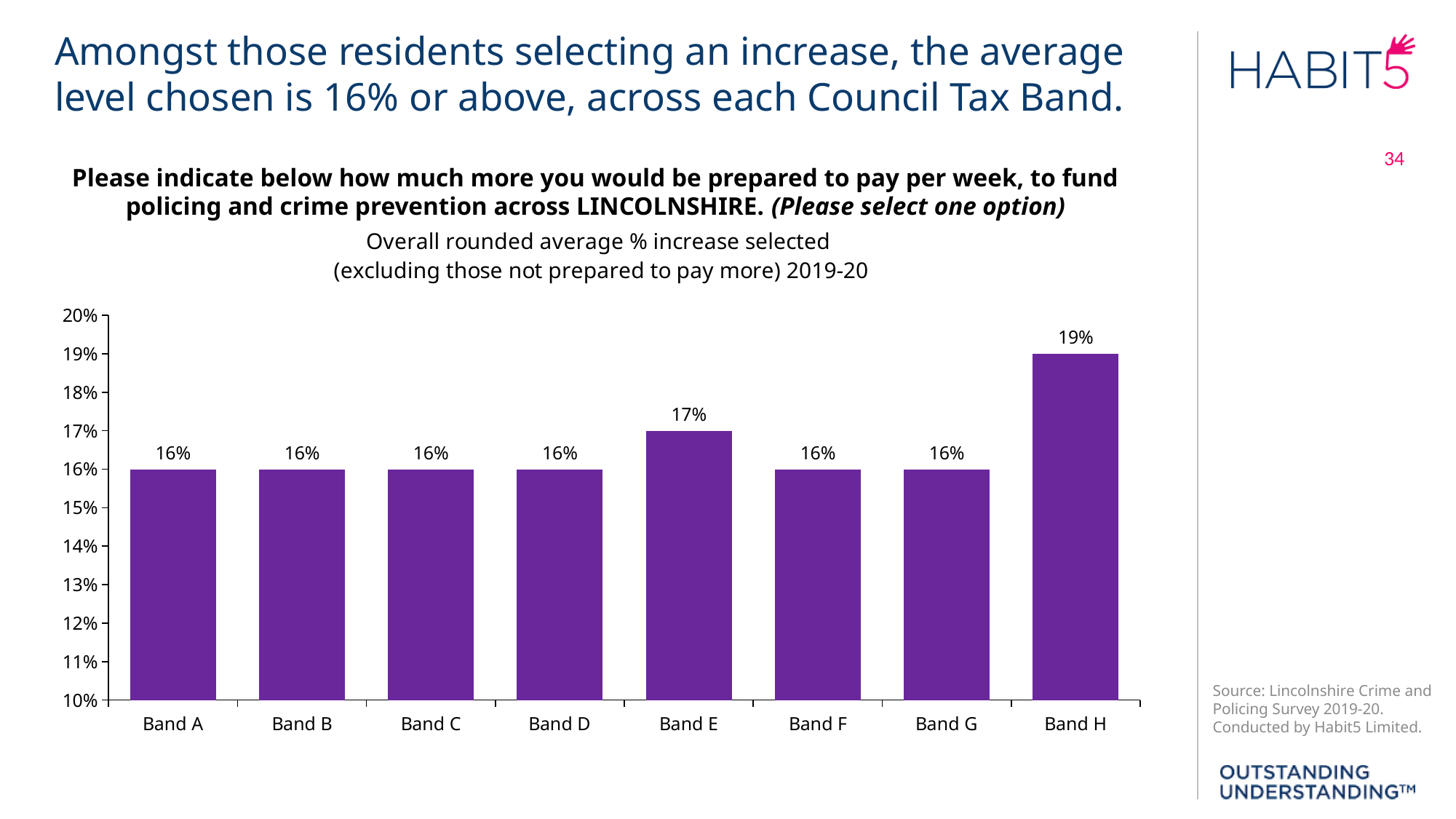
What is the difference between the average % increase for Band E and Band D? 1% How many Council Tax Bands are shown on the chart? 8 What kind of chart is shown on the slide? Bar chart What is the difference between the average % increase for Band H and Band E? 2% Is the value for Band H greater or less than 18%? greater Which is larger, the average % increase for Band H or for Band E? Band H What colour are the bars in the chart? Purple What is the overall rounded average % increase selected for Band E? 17% Which Council Tax Band has the highest average % increase selected? Band H What is the overall rounded average % increase selected for Band A? 16% What is the overall rounded average % increase selected for Band H? 19% How many bands have an average % increase of 16%? 6